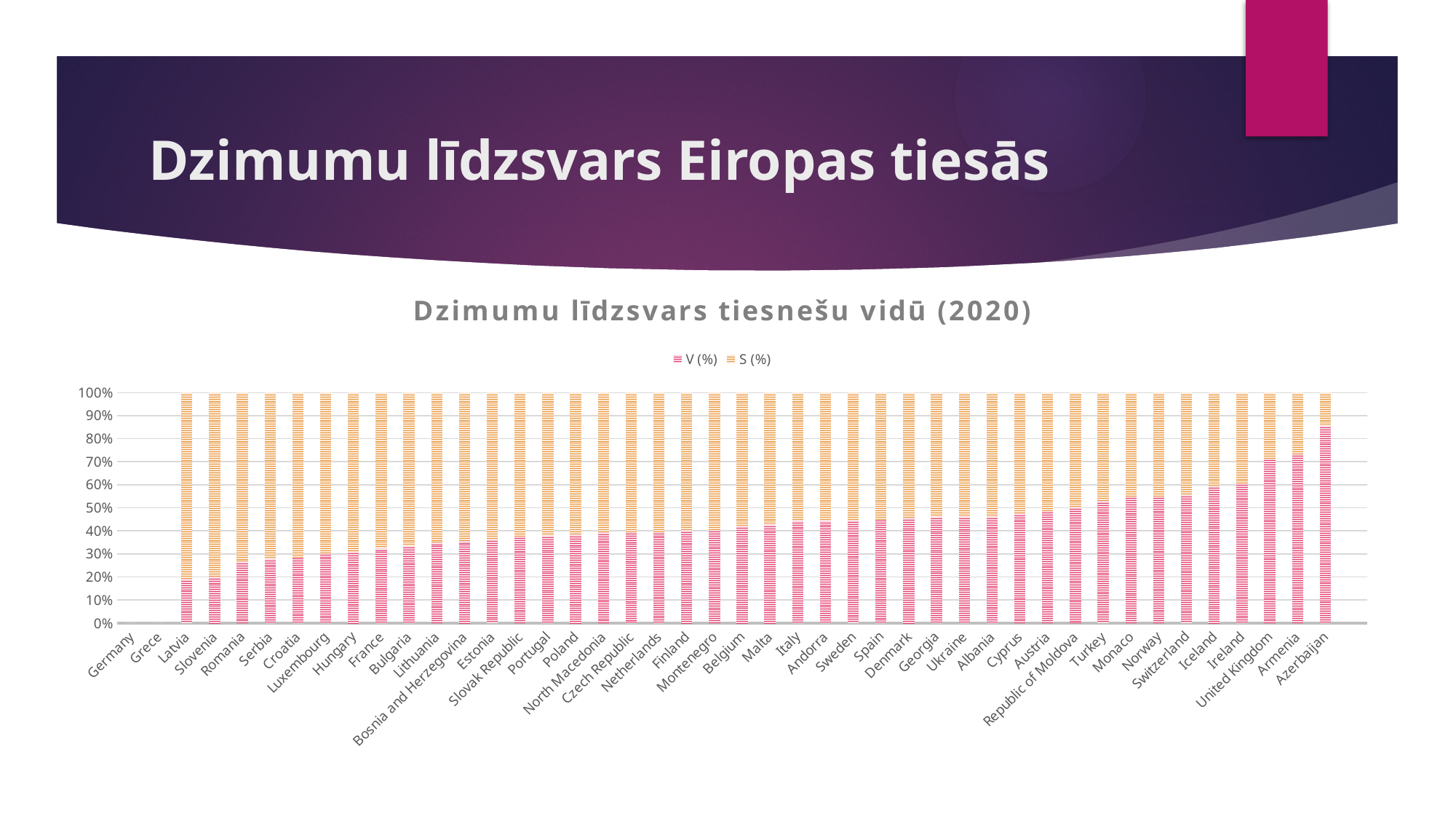
Which has the larger V (%) value, Latvia or Azerbaijan? Azerbaijan What type of chart is shown on the slide? Stacked bar chart Is the V (%) value for Azerbaijan greater or less than 80%? greater What are the two series named in the legend? V (%) and S (%) Is the V (%) value for United Kingdom greater or less than 60%? greater Which country has the highest V (%) value? Azerbaijan Is the V (%) value for Italy greater or less than 40%? greater How many series does the legend list? 2 How many countries are listed on the x axis? 44 What is the title of the chart? Dzimumu līdzsvars tiesnešu vidū (2020) Do the V (%) values generally rise or fall moving from left to right along the x axis? rise